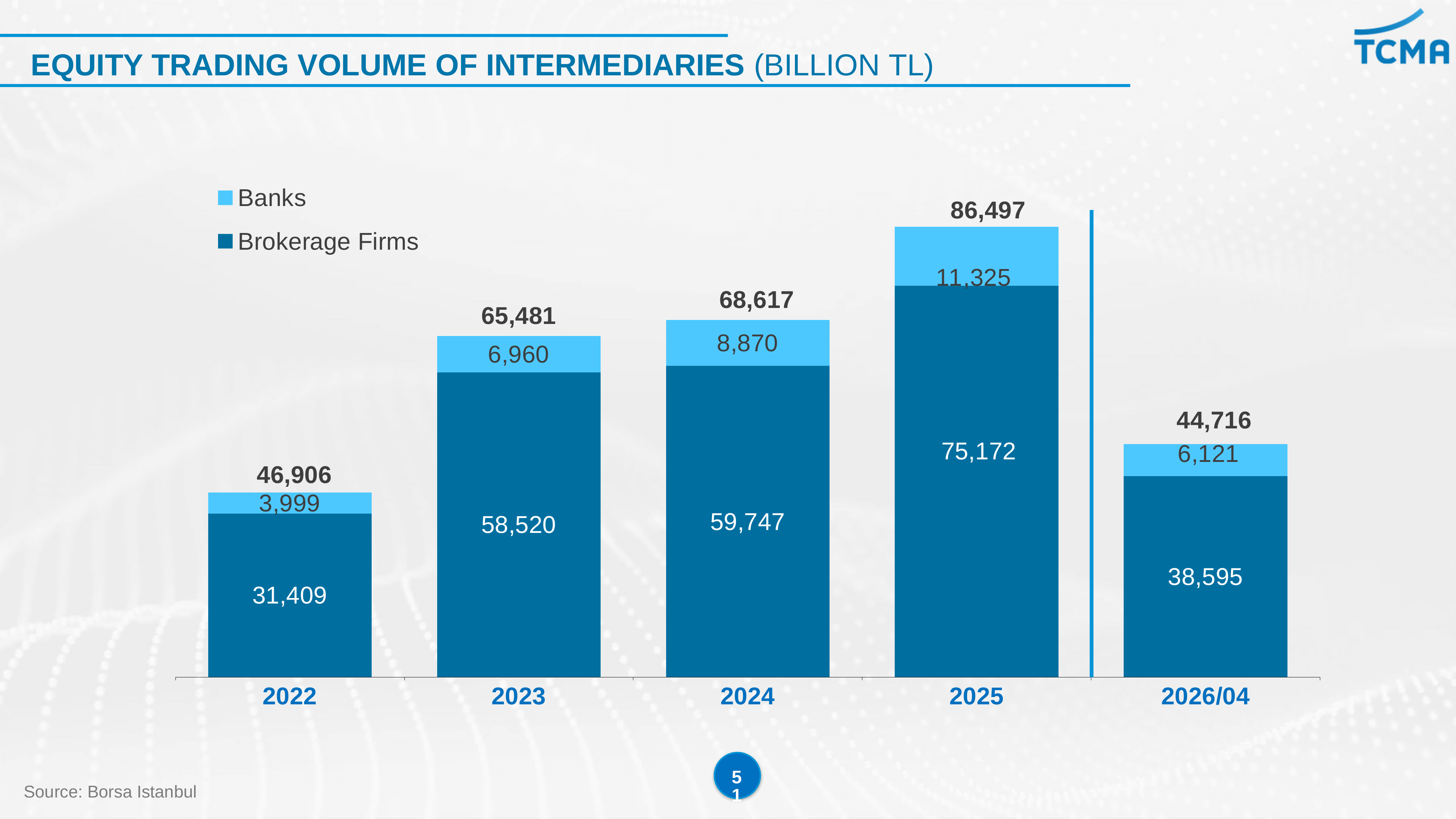
By how much did the Brokerage Firms value increase from 2024 to 2025? 15,425 What is the total equity trading volume shown for 2023? 65,481 Do the total values rise or fall from 2022 to 2025? Rise What kind of chart is shown on the slide? Stacked bar chart What is the Banks value for 2025? 11,325 What is the difference between the Banks values for 2023 and 2022? 2,961 Which year has the highest total equity trading volume? 2025 How many periods are shown on the x axis? 5 How many series does the legend list? 2 Which period has the lowest total equity trading volume? 2026/04 What is the Brokerage Firms value for 2024? 59,747 Which is larger, the Banks value for 2024 or for 2026/04? 2024